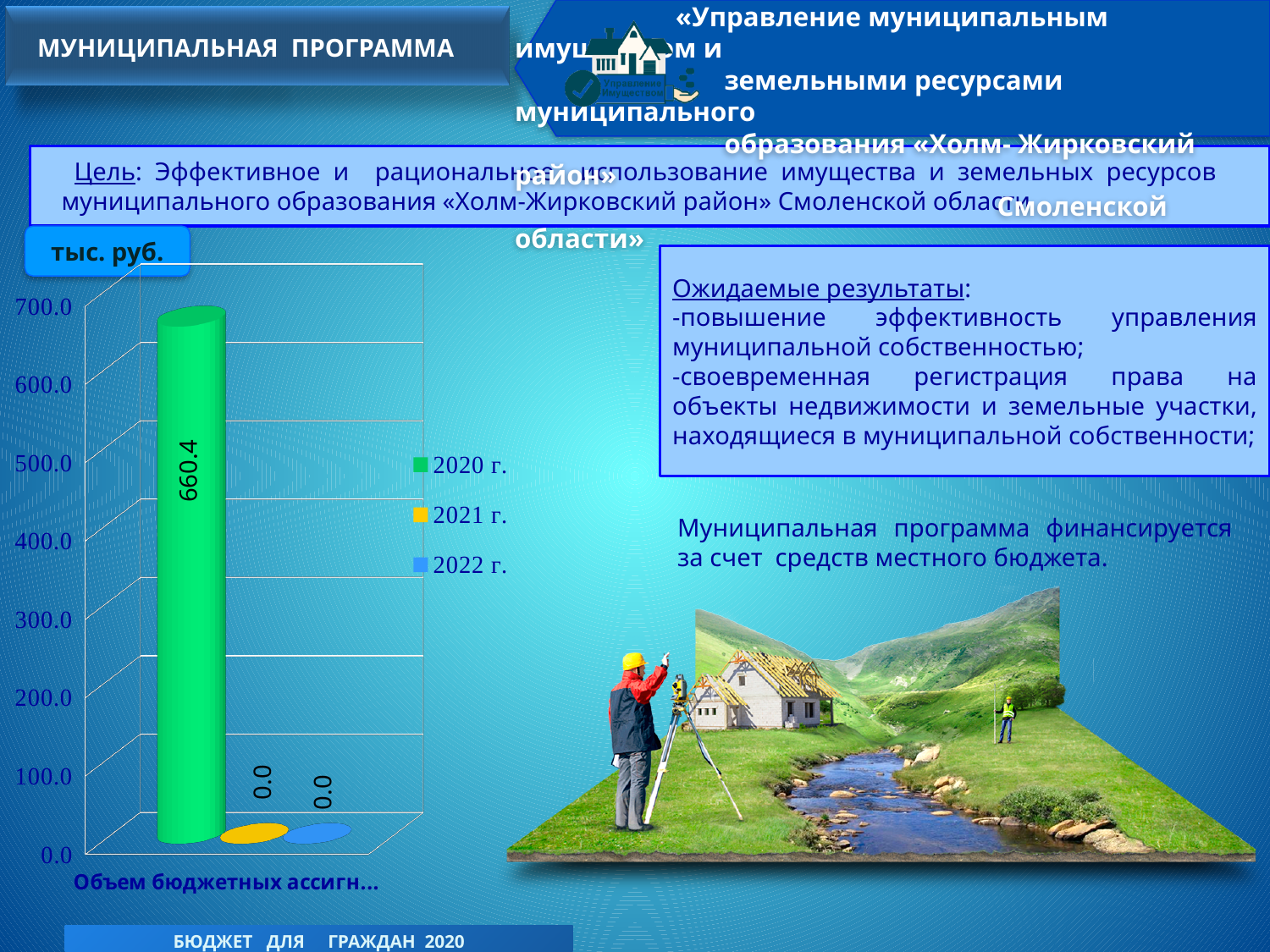
What colour is the bar for the 2020 г. series? green What is the difference between the 2020 г. value and the 2021 г. value? 660.4 Is the value for 2020 г. greater or less than 700.0? less What is the value for the 2021 г. series on the chart? 0.0 What is the value for the 2020 г. series on the chart? 660.4 What kind of chart is shown on the slide? bar chart Which is larger, the value for 2020 г. or the value for 2022 г.? 2020 г. How many series does the chart legend list? 3 What is the value for the 2022 г. series on the chart? 0.0 Which series has the highest value on the chart? 2020 г. What unit of measurement is indicated for the chart values? тыс. руб. Is the value for 2020 г. greater or less than 600.0? greater